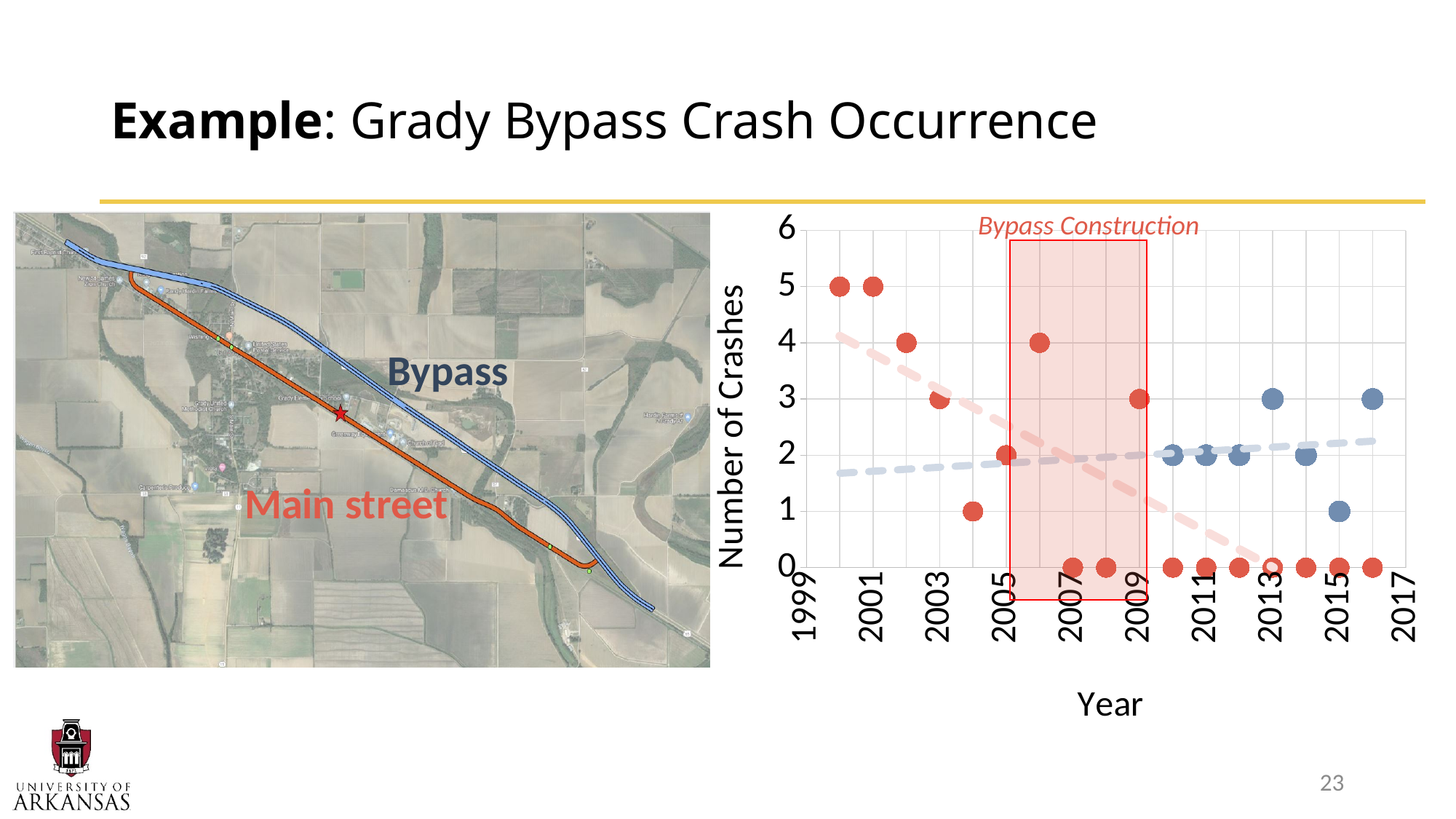
What is the y-axis title of the chart? Number of Crashes What is the difference between the red series values for 2001 and 2003? 2 How many crashes does the red series show for 2009? 3 In 2011, which series has the larger value, red or blue? blue What is the highest number of crashes shown for the red series? 5 How many crashes does the red series show for 2001? 5 How many crashes does the blue series show for 2015? 1 What type of chart is shown on the right of the slide? scatter chart What label is shown on the shaded region of the chart? Bypass Construction How many crashes does the red series show for 2003? 3 In which year does the blue series reach its lowest value? 2015 How many crashes does the blue series show for 2013? 3